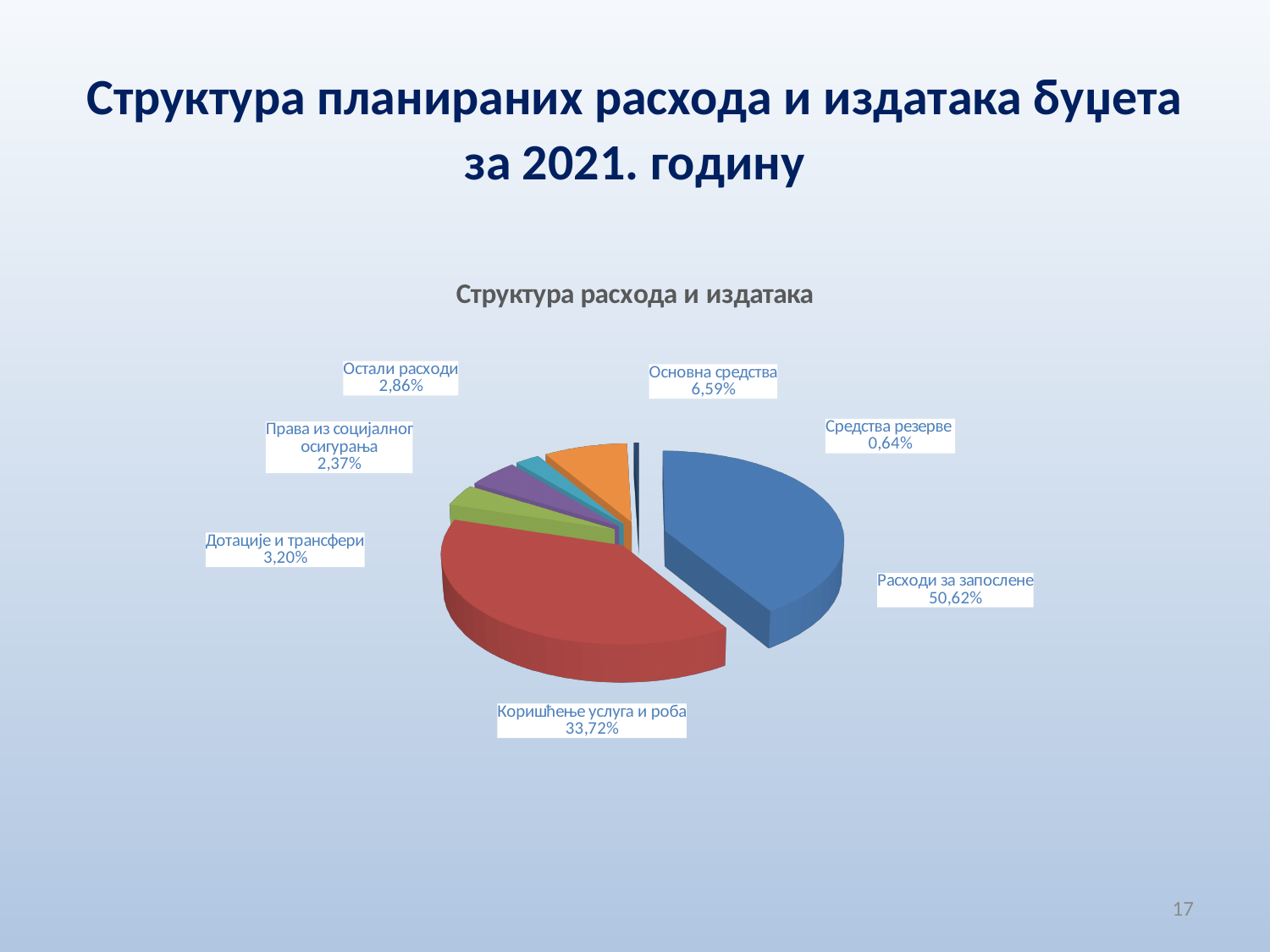
Which category has the largest share of the pie? Расходи за запослене What percentage is labelled for Основна средства? 6,59% What is the title of the chart? Структура расхода и издатака What is the difference in percentage points between Расходи за запослене and Коришћење услуга и роба? 16,90 What is the value for Средства резерве? 0,64% What type of chart is shown on the slide? Pie chart Which category has the smallest share of the pie? Средства резерве What percentage is shown for Дотације и трансфери? 3,20% What share of the pie does Расходи за запослене represent? 50,62% What is the value shown for Коришћење услуга и роба? 33,72% How many categories are shown in the pie chart? 7 Which is larger, Остали расходи or Права из социјалног осигурања? Остали расходи